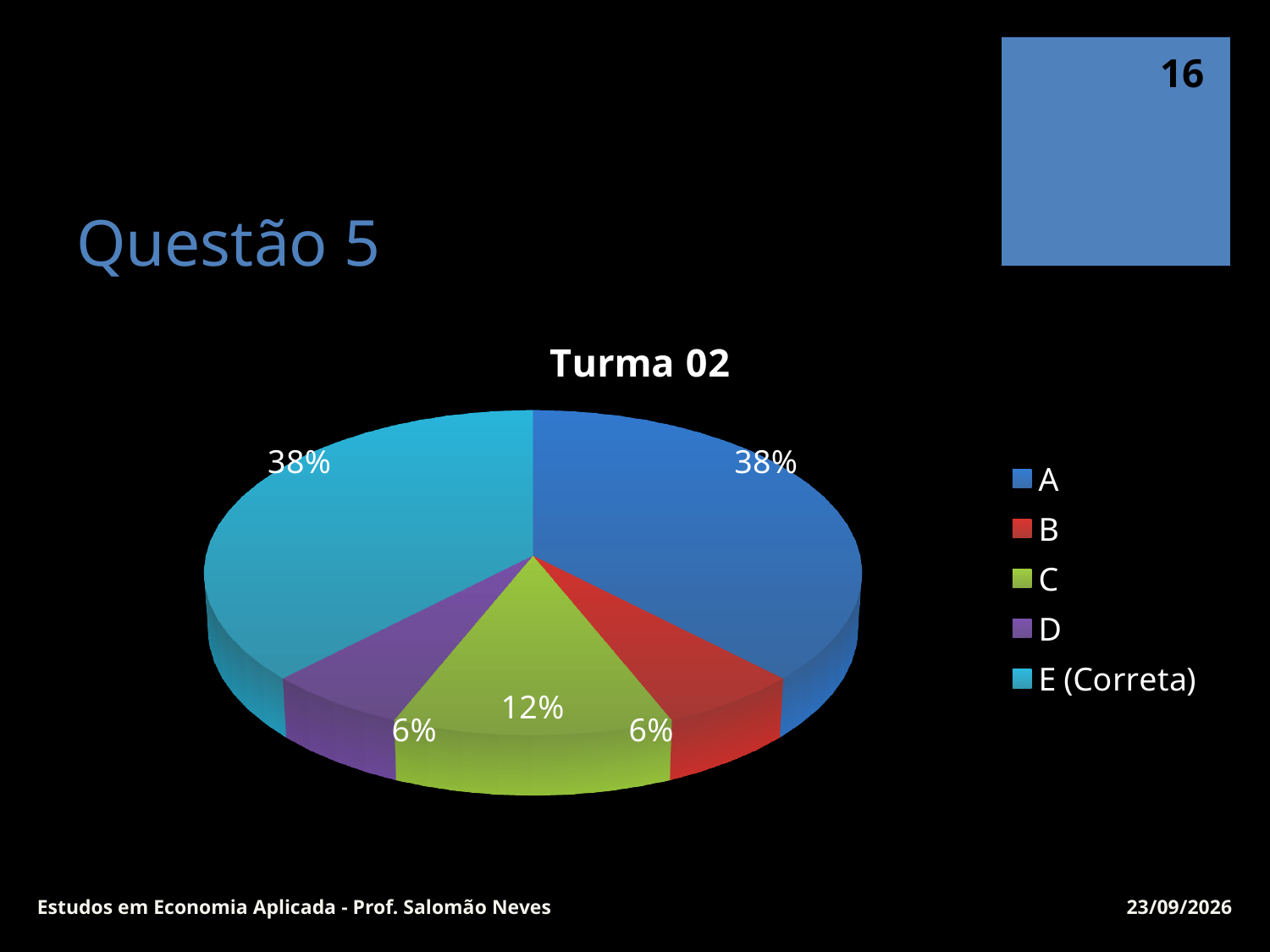
What percentage of the pie does slice D represent? 6% What is the difference in percentage points between slice A and slice C? 26 What percentage of the pie does slice C represent? 12% What percentage of the pie does slice E (Correta) represent? 38% How many slices does the pie chart have? 5 Which is larger, the share for A or the share for C? A What percentage of the pie does slice A represent? 38% Which legend entry is marked as the correct answer? E (Correta) What type of chart is shown on the slide? pie chart What percentage of the pie does slice B represent? 6% How many entries does the legend list? 5 What is the title of the chart? Turma 02